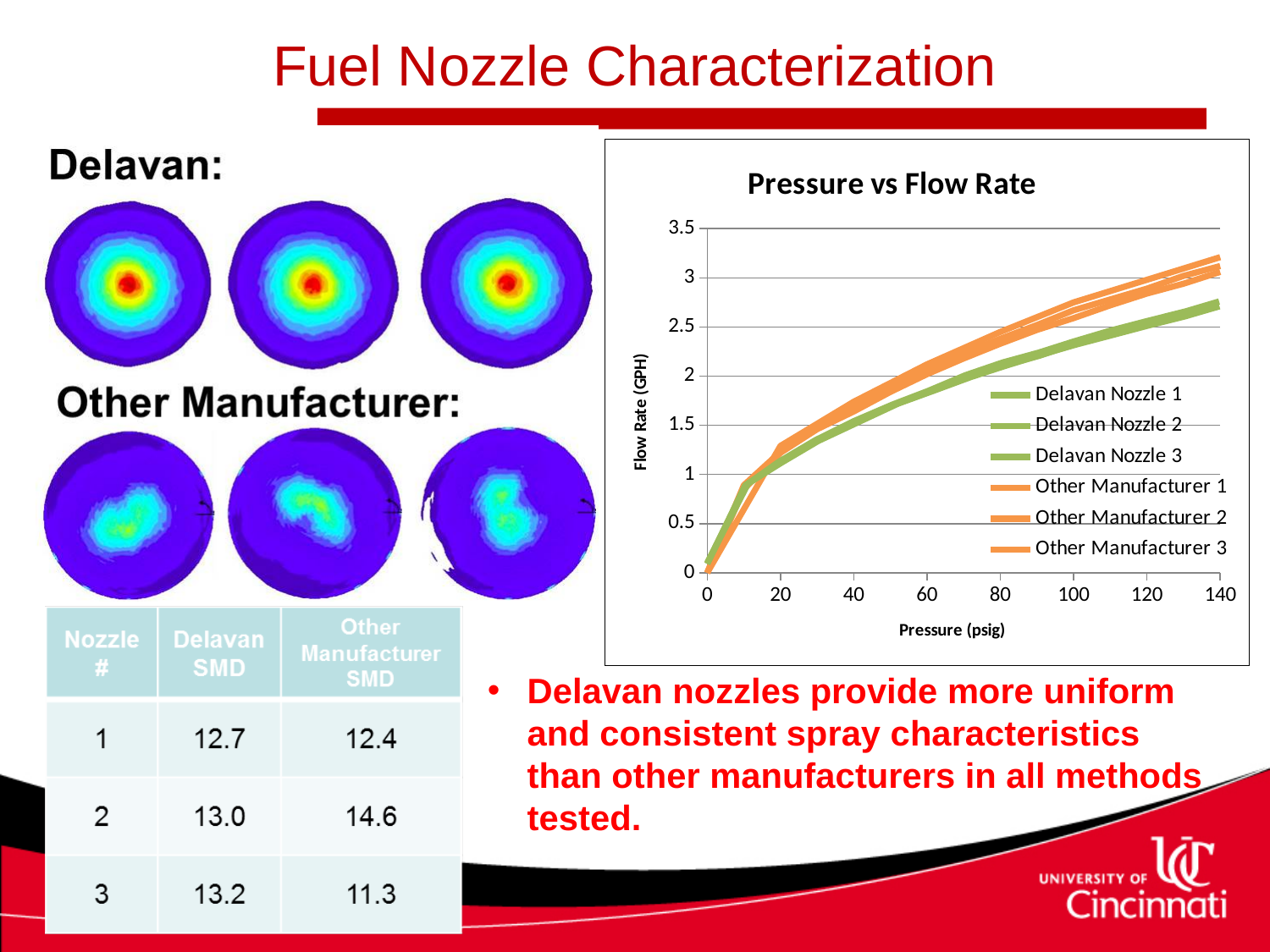
Is the flow rate for Delavan Nozzle 1 at 140 psig greater or less than 3 GPH? less What kind of chart is shown on the slide? line chart At 120 psig, which has the higher flow rate: Delavan Nozzle 3 or Other Manufacturer 3? Other Manufacturer 3 What is the title of the chart? Pressure vs Flow Rate At 140 psig, which has the higher flow rate: Delavan Nozzle 1 or Other Manufacturer 1? Other Manufacturer 1 What is the highest pressure value shown on the x axis of the chart? 140 Does the flow rate rise or fall as pressure increases along the x axis? rise Is the flow rate for Delavan Nozzle 2 at 100 psig greater or less than 2.5 GPH? less How many series does the chart's legend list? 6 What is the label of the x axis of the chart? Pressure (psig)